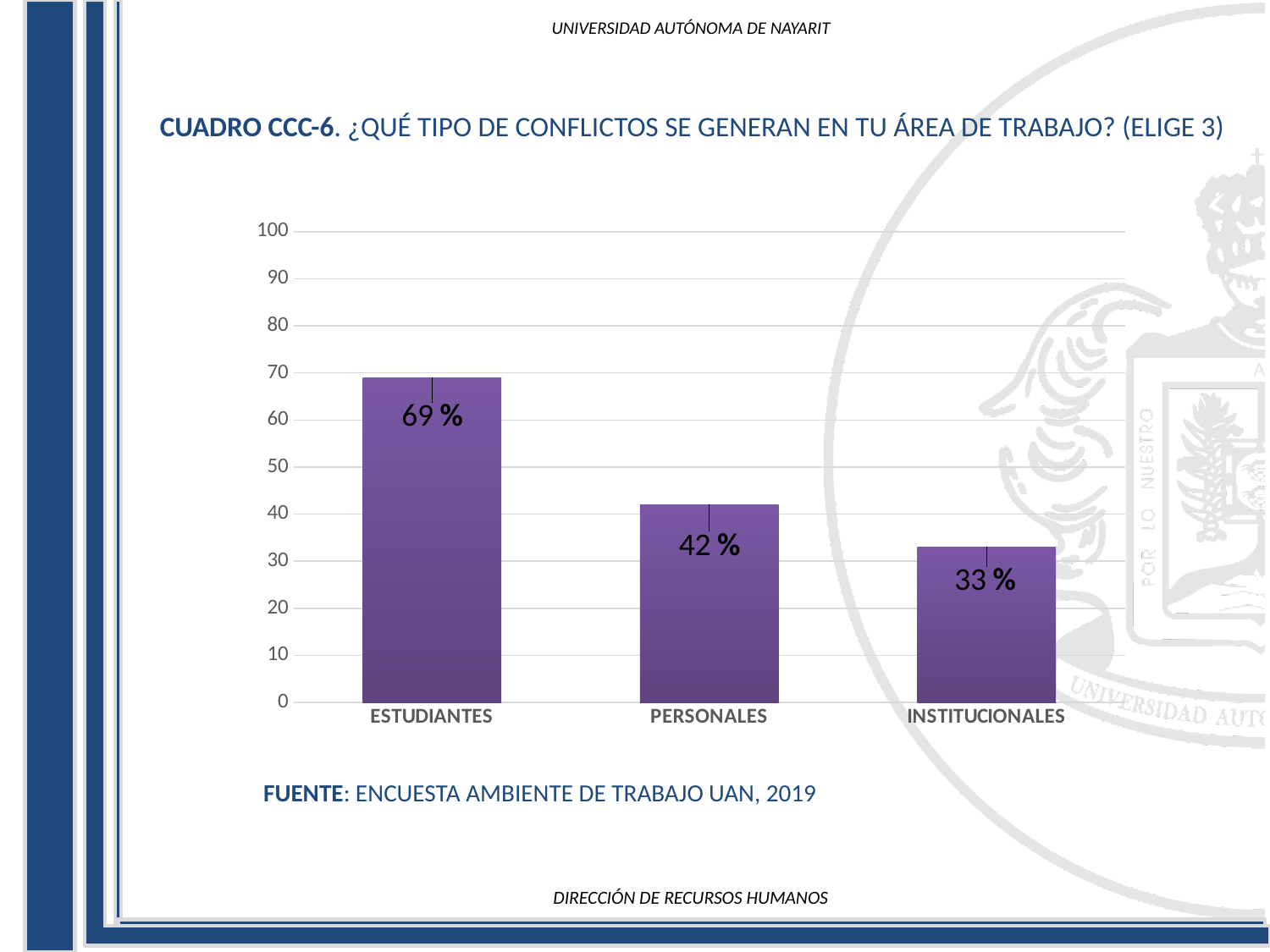
What is the value for PERSONALES? 42 % Which is larger, the value for PERSONALES or the value for INSTITUCIONALES? PERSONALES What is the difference between the values for PERSONALES and INSTITUCIONALES? 9 % How many categories are shown on the x axis? 3 Which category has the lowest value? INSTITUCIONALES Which category has the highest value? ESTUDIANTES What is the value for ESTUDIANTES? 69 % What is the value for INSTITUCIONALES? 33 % Is the value for ESTUDIANTES greater or less than 60? greater What kind of chart is shown on the slide? bar chart What is the difference between the values for ESTUDIANTES and PERSONALES? 27 % Do the values rise or fall from left to right along the x axis? fall